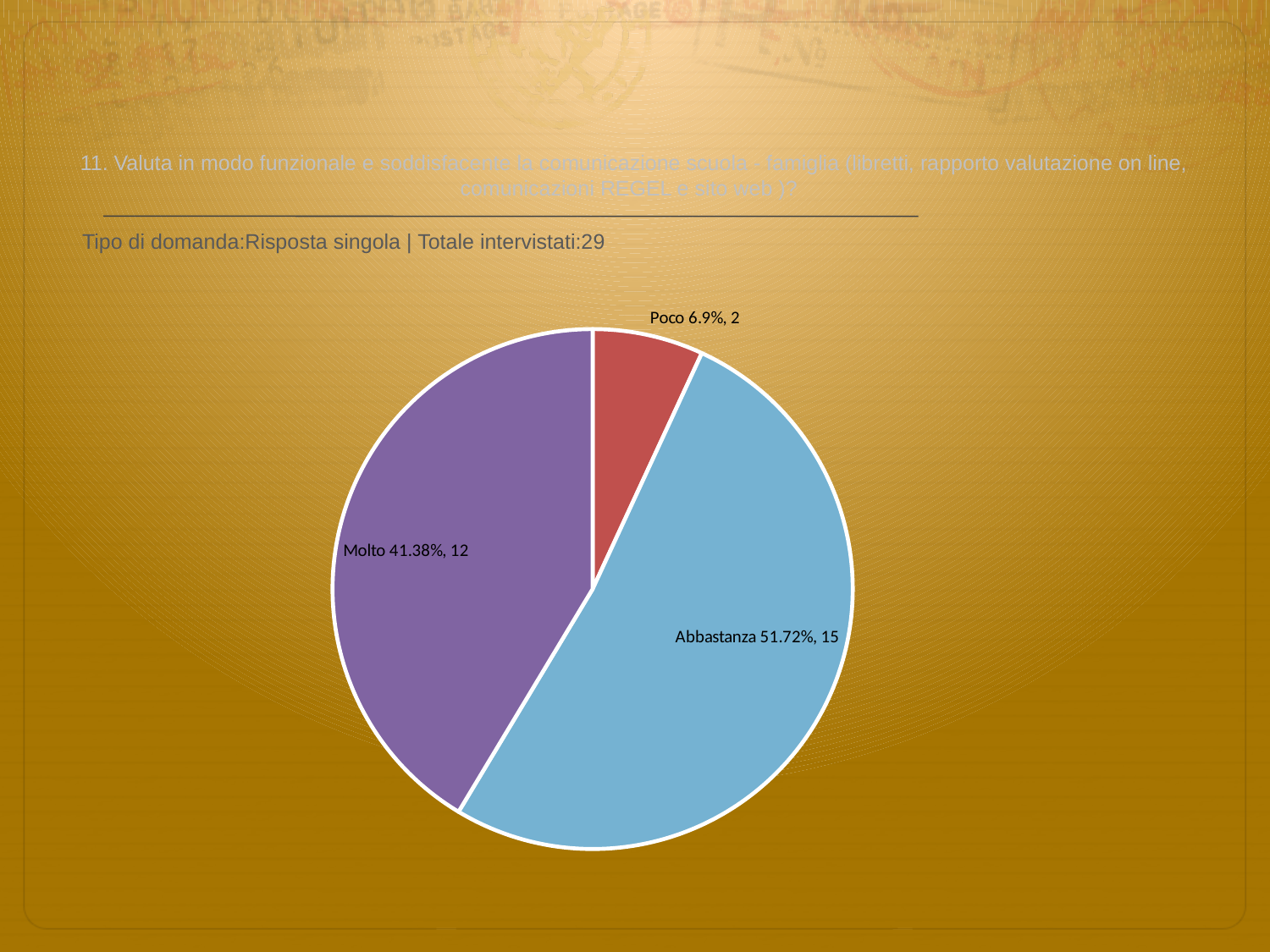
How many respondents answered Molto? 12 What kind of chart is shown on the slide? pie chart What percentage share does the Poco slice have? 6.9% What percentage share does the Molto slice have? 41.38% What is the difference in respondent count between Abbastanza and Molto? 3 What percentage share does the Abbastanza slice have? 51.72% How many slices does the pie chart have? 3 How many respondents answered Poco? 2 Which category has the largest slice of the pie? Abbastanza How many respondents answered Abbastanza? 15 Which slice is larger, Molto or Poco? Molto Which category has the smallest slice of the pie? Poco